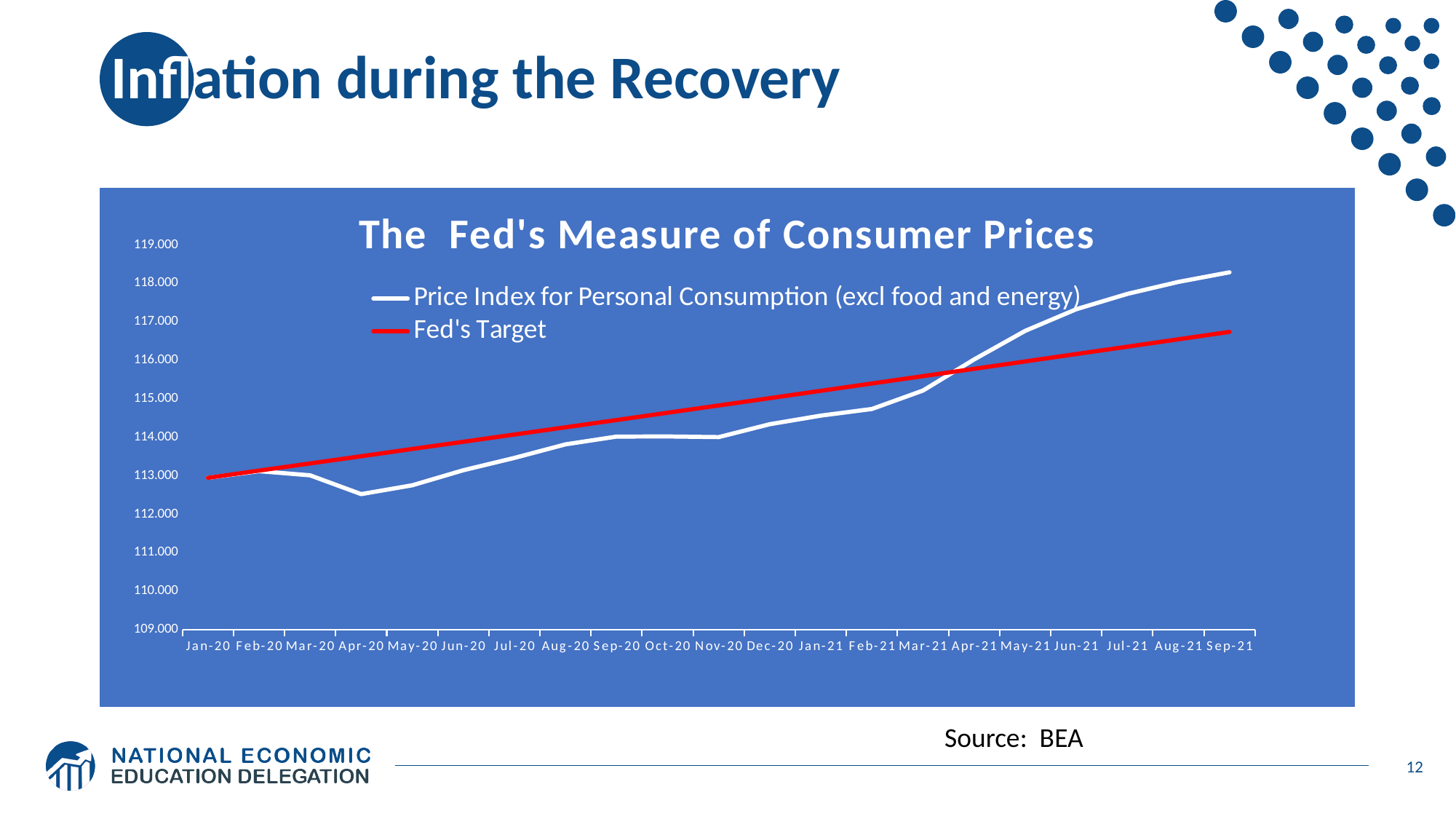
Is the Price Index for Personal Consumption (excl food and energy) in Sep-21 greater or less than 118.000? greater What kind of chart is shown on the slide? line chart What is the title of the chart? The Fed's Measure of Consumer Prices Is the Fed's Target value in Sep-21 greater or less than 117.000? less How many months are shown on the x axis? 21 In which month is the Price Index for Personal Consumption (excl food and energy) at its lowest? Apr-20 Does the Fed's Target line rise or fall from Jan-20 to Sep-21? rise In which month is the Price Index for Personal Consumption (excl food and energy) at its highest? Sep-21 In Apr-20, which is higher: the Price Index for Personal Consumption (excl food and energy) or the Fed's Target? Fed's Target Which series is drawn in red? Fed's Target Is the Price Index for Personal Consumption (excl food and energy) in Apr-20 greater or less than 113.000? less How many series does the legend list? 2